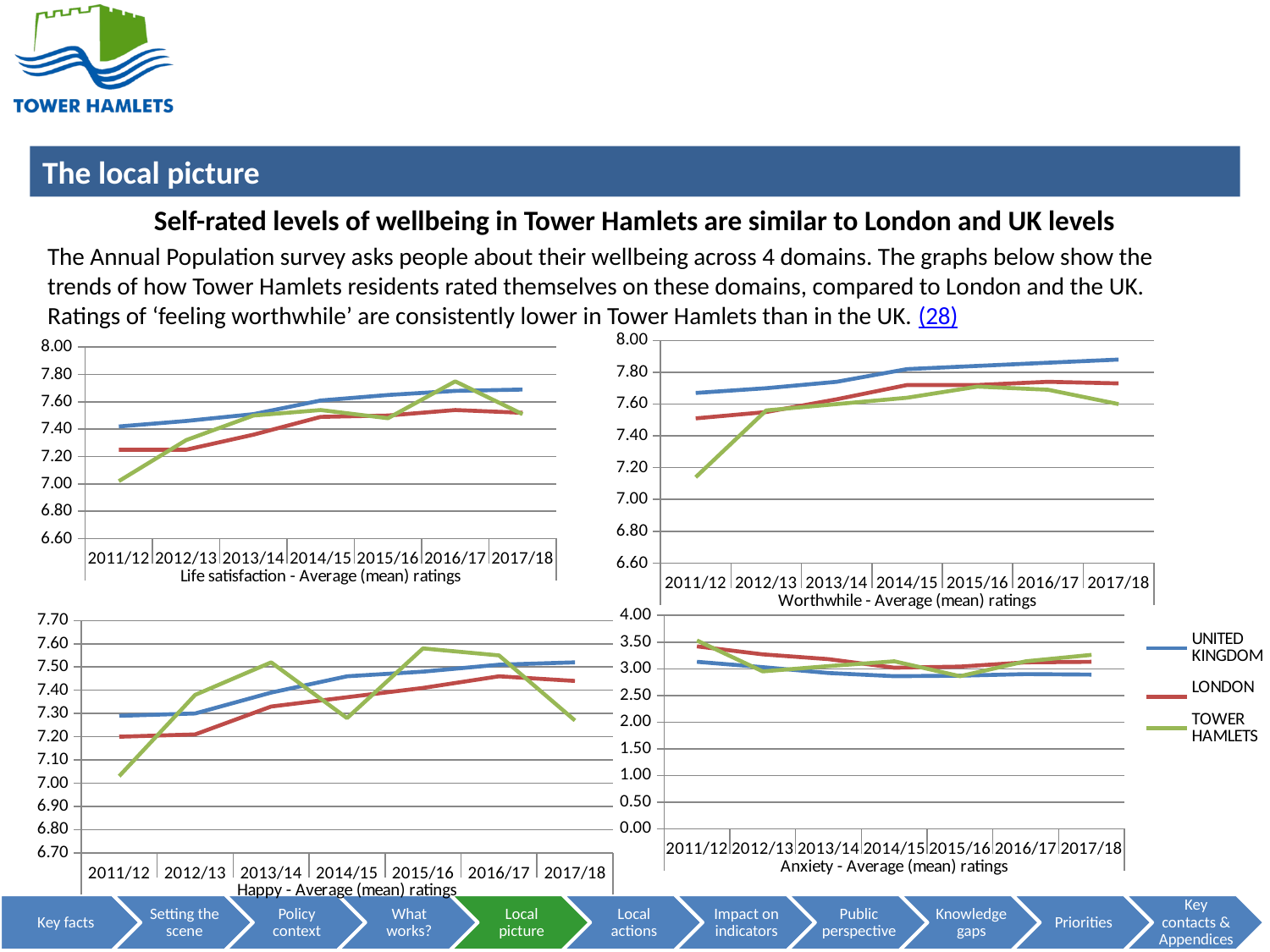
In the 'Life satisfaction - Average (mean) ratings' chart, in which year is the Tower Hamlets value highest? 2016/17 In the 'Life satisfaction - Average (mean) ratings' chart, is the Tower Hamlets value for 2011/12 greater or less than 7.20? less In the 'Happy - Average (mean) ratings' chart, in which year is the Tower Hamlets value lowest? 2011/12 In the 'Worthwhile - Average (mean) ratings' chart, does the United Kingdom line rise or fall from 2011/12 to 2017/18? rise How many time periods are shown on the x axis of the 'Worthwhile - Average (mean) ratings' chart? 7 What kind of chart is the 'Life satisfaction - Average (mean) ratings' chart? line chart Which three areas are named in the legend on the right of the slide? United Kingdom, London, Tower Hamlets How many series does the legend on the right of the slide list? 3 In the 'Worthwhile - Average (mean) ratings' chart, which is higher in 2011/12: United Kingdom or Tower Hamlets? United Kingdom In the 'Life satisfaction - Average (mean) ratings' chart, which is higher in 2011/12: United Kingdom or London? United Kingdom In the 'Anxiety - Average (mean) ratings' chart, is the Tower Hamlets value for 2011/12 greater or less than 3.00? greater In the 'Worthwhile - Average (mean) ratings' chart, is the United Kingdom value for 2017/18 greater or less than 7.80? greater